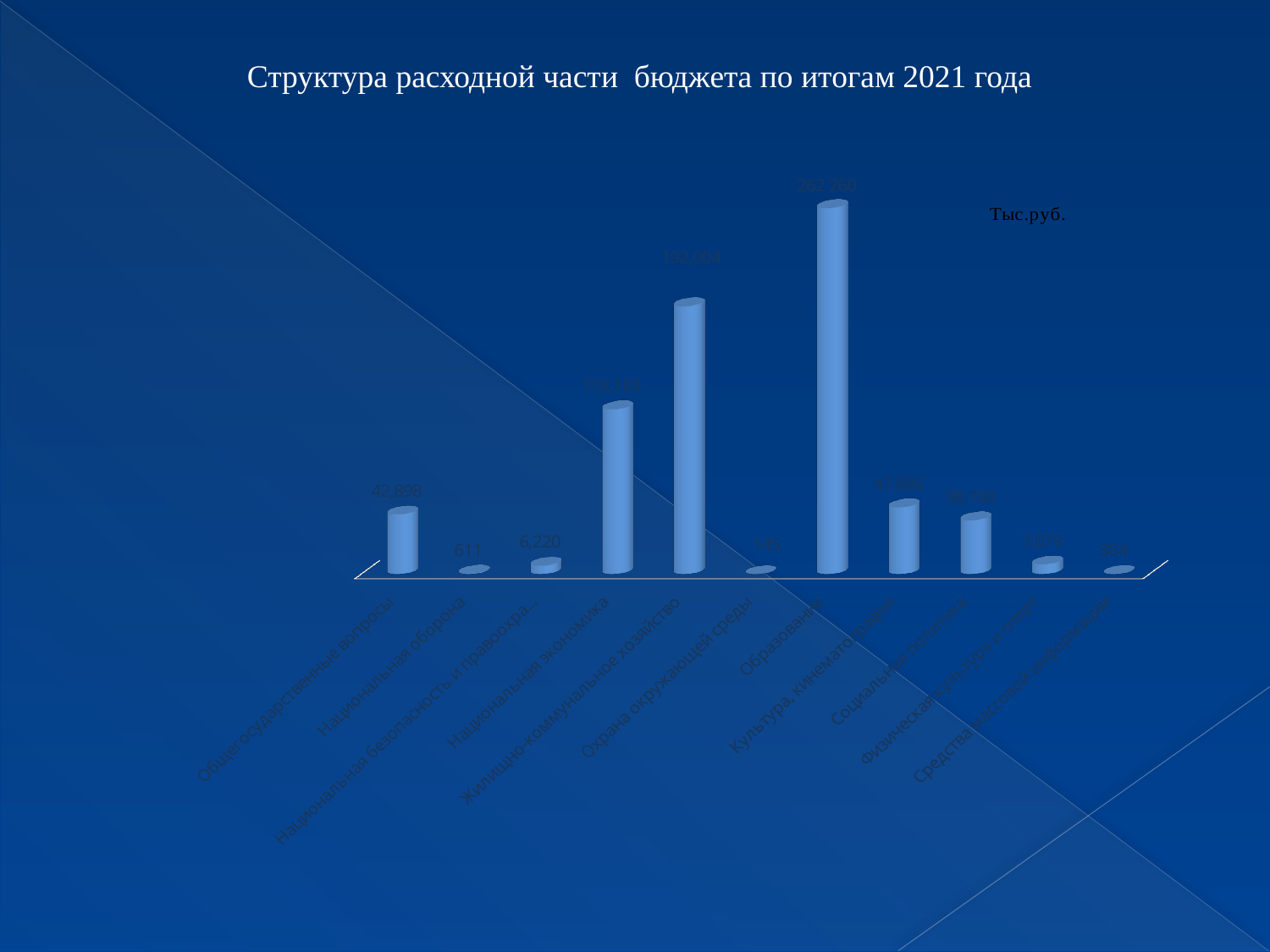
Which is larger, the value for Образование or the value for Жилищно-коммунальное хозяйство? Образование What unit is indicated for the values in the chart? Тыс.руб. What is the value for Образование? 262,260 What is the difference between the values for Общегосударственные вопросы and Национальная оборона? 42,287 What is the value for Национальная оборона? 611 How many categories are plotted in the chart? 11 Which category has the highest value? Образование What kind of chart is shown on the slide? bar chart What is the difference between the values for Образование and Общегосударственные вопросы? 219,362 Which is larger, the value for Общегосударственные вопросы or the value for Национальная оборона? Общегосударственные вопросы What is the value for Общегосударственные вопросы? 42,898 What is the title of the chart? Структура расходной части бюджета по итогам 2021 года